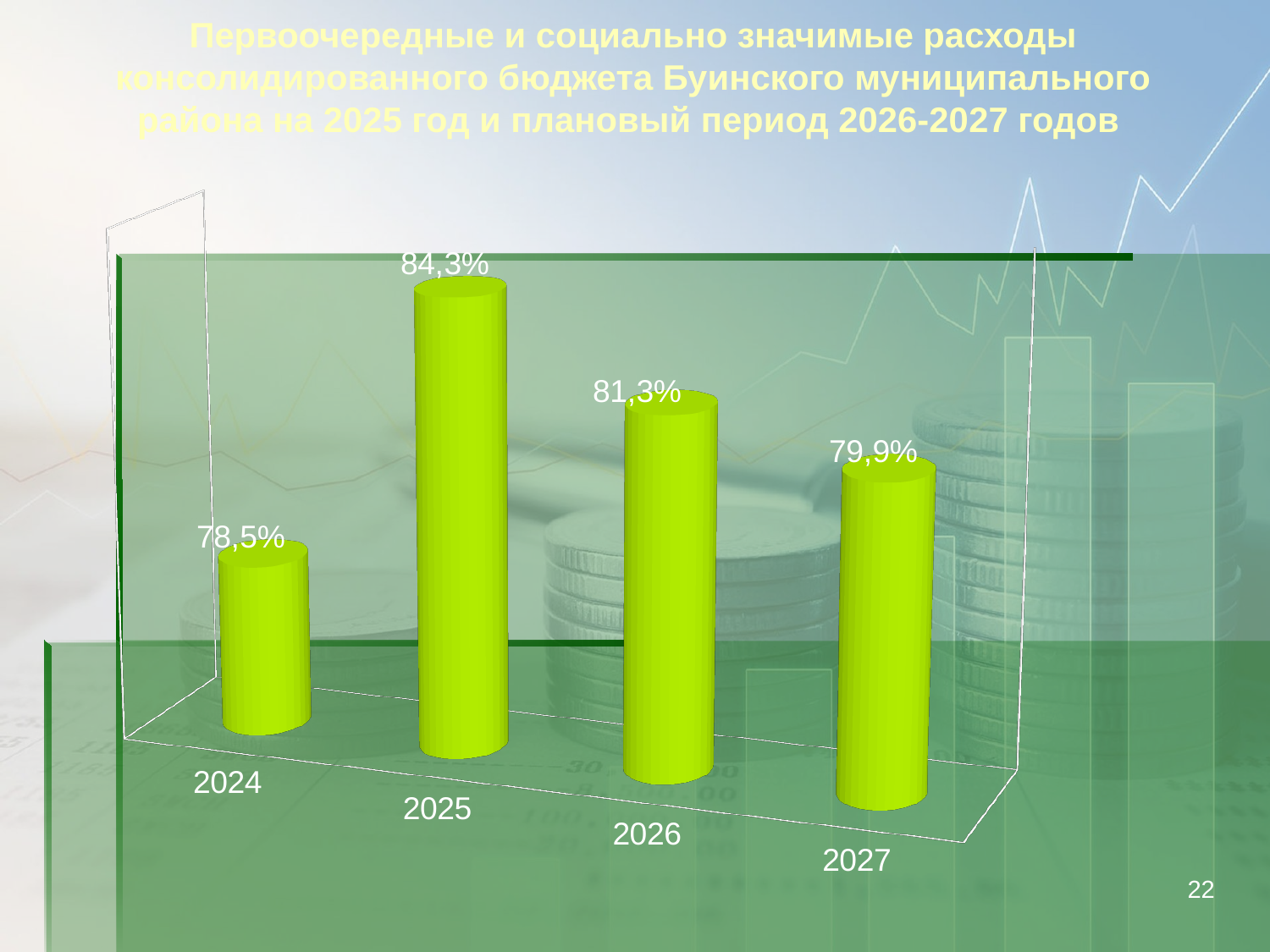
What is the value for 2024? 78,5% What is the value for 2027? 79,9% What kind of chart is shown on the slide? bar chart What is the value for 2025? 84,3% Which year has the highest value? 2025 Do the values rise or fall from 2025 to 2027? fall Which year has the lowest value? 2024 What is the difference between the values for 2025 and 2024? 5,8% Which is larger, the value for 2026 or the value for 2027? 2026 How many years are shown on the chart? 4 What is the value for 2026? 81,3% What is the difference between the values for 2026 and 2027? 1,4%